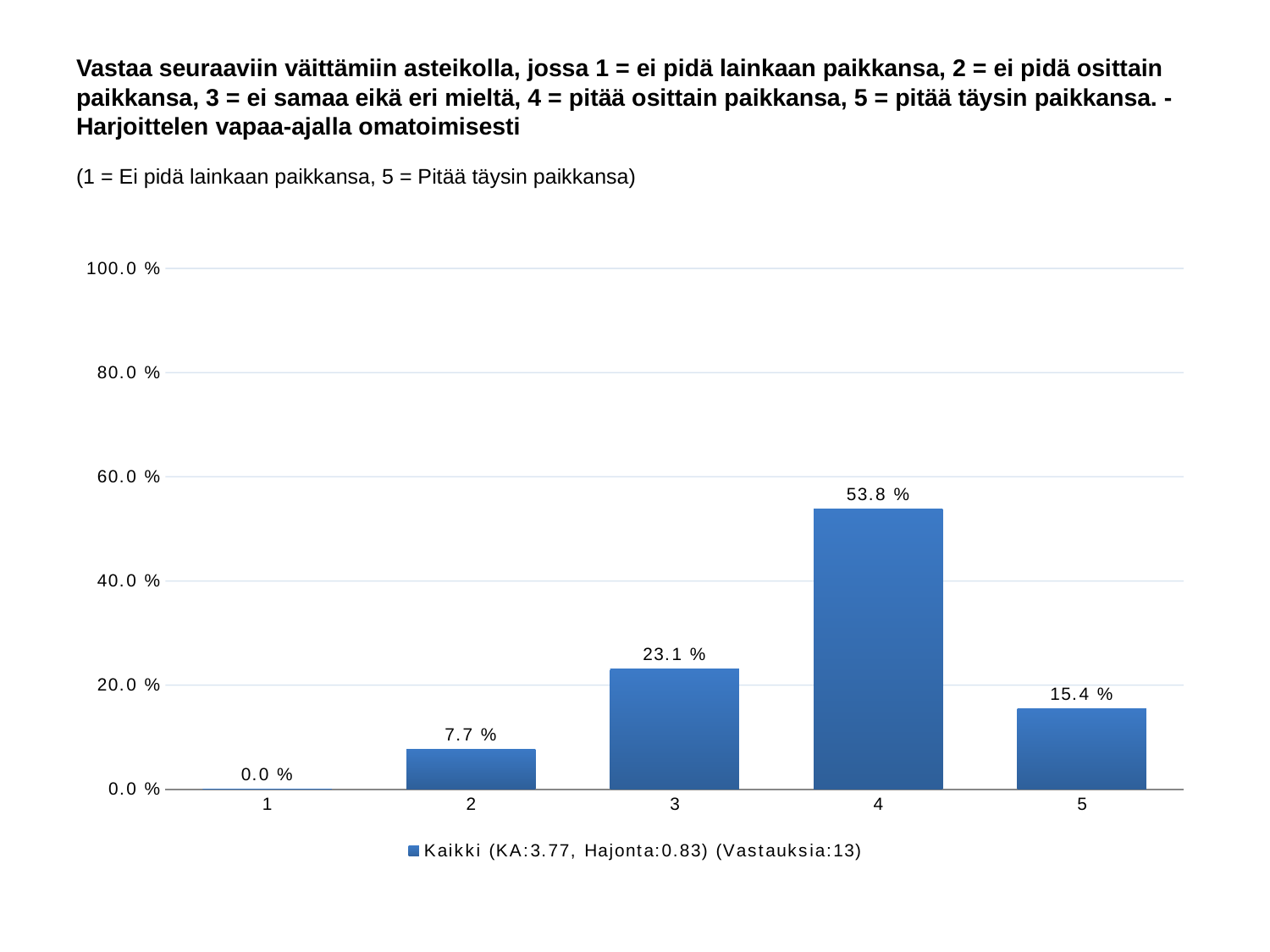
What kind of chart is shown? bar chart What is the value for category 5? 15.4 % Which is larger, the value for category 3 or the value for category 5? 3 Is the value for category 4 greater or less than 40.0 %? greater What is the difference between the values for categories 4 and 3? 30.7 % What is the value for category 2? 7.7 % Which category has the highest value? 4 How many responses (Vastauksia) does the legend report? 13 How many series does the legend list? 1 What is the value for category 4? 53.8 % How many categories are shown on the x axis? 5 Which category has the lowest value? 1